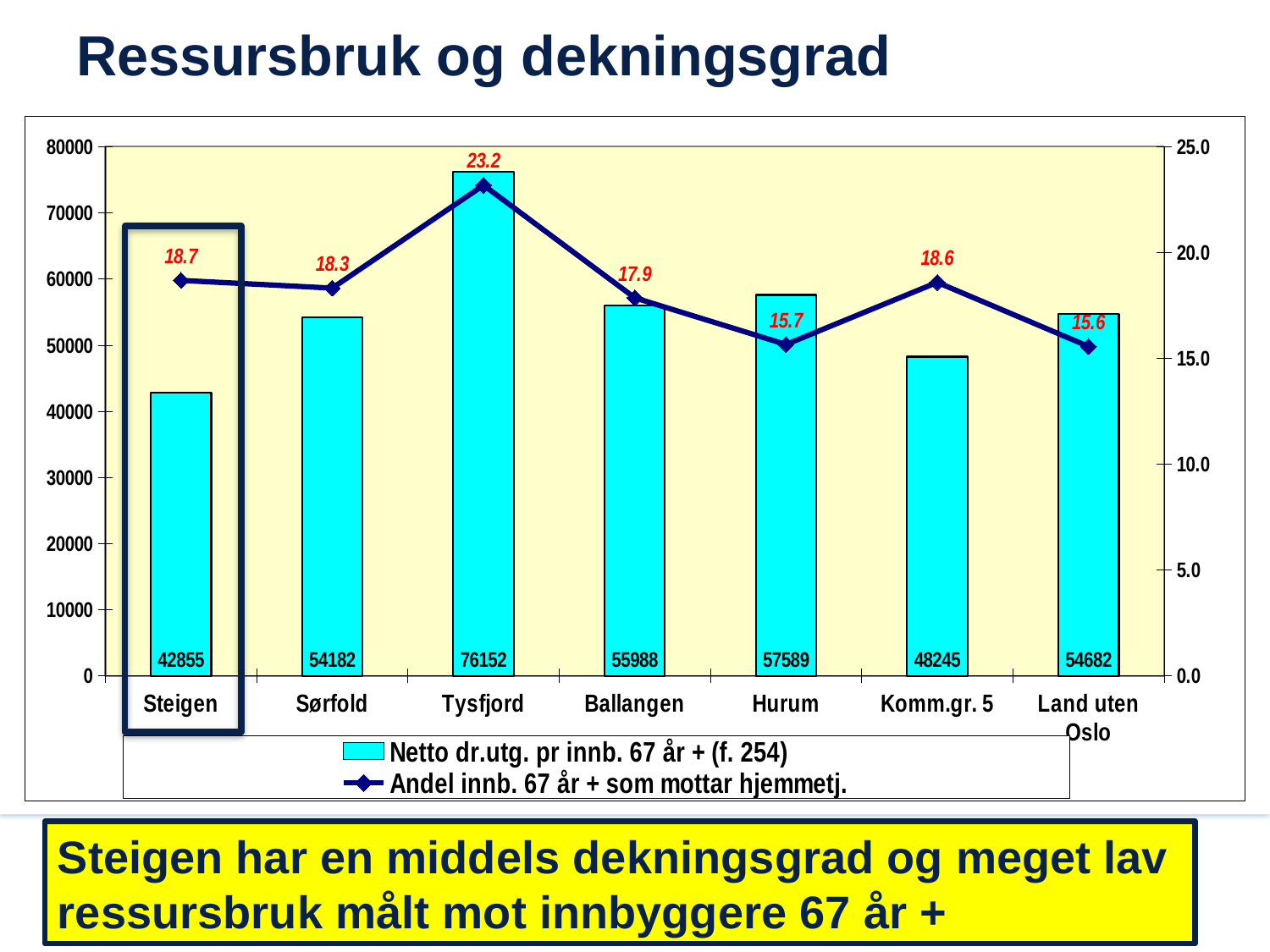
Which category has the lowest Netto dr.utg. pr innb. 67 år + (f. 254)? Steigen What is the difference in Netto dr.utg. pr innb. 67 år + (f. 254) between Tysfjord and Steigen? 33297 What is the value of Andel innb. 67 år + som mottar hjemmetj. for Tysfjord? 23.2 Which category has the lowest Andel innb. 67 år + som mottar hjemmetj.? Land uten Oslo What is the value of Netto dr.utg. pr innb. 67 år + (f. 254) for Komm.gr. 5? 48245 Which category has the highest Netto dr.utg. pr innb. 67 år + (f. 254)? Tysfjord Which has a higher Netto dr.utg. pr innb. 67 år + (f. 254), Hurum or Ballangen? Hurum How many categories are shown on the x axis? 7 What is the title of the slide containing the chart? Ressursbruk og dekningsgrad What is the value of Netto dr.utg. pr innb. 67 år + (f. 254) for Steigen? 42855 What is the value of Andel innb. 67 år + som mottar hjemmetj. for Land uten Oslo? 15.6 How many series does the legend list? 2